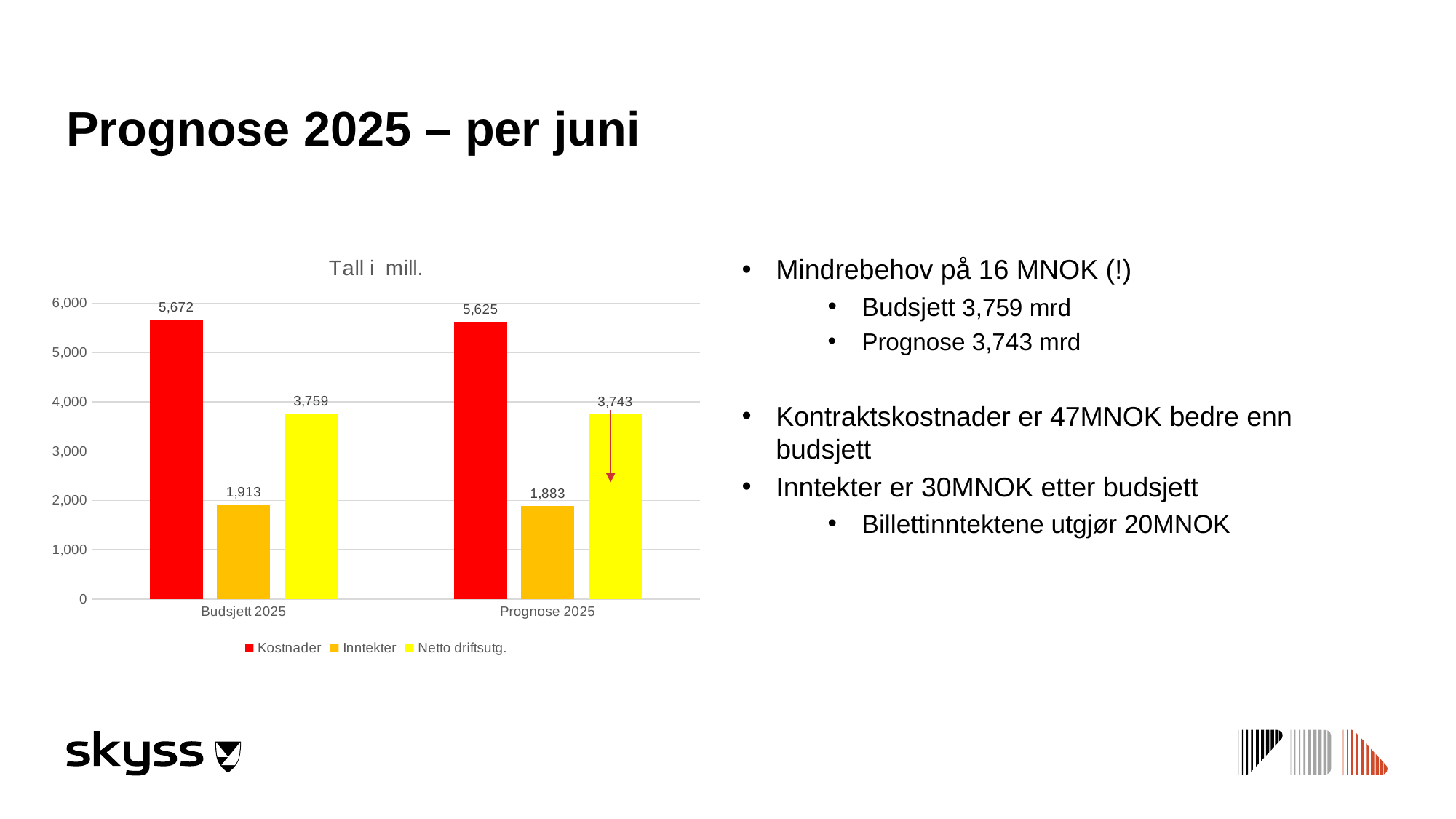
What is the value of Inntekter for Prognose 2025? 1,883 What is the difference between Kostnader for Budsjett 2025 and Kostnader for Prognose 2025? 47 What kind of chart is shown on the slide? bar chart Which series has the lowest value for Budsjett 2025? Inntekter How many series does the legend list? 3 What is the value of Netto driftsutg. for Budsjett 2025? 3,759 What is the difference between Netto driftsutg. for Budsjett 2025 and for Prognose 2025? 16 Is the value of Netto driftsutg. for Prognose 2025 greater or less than 4,000? less How many categories are shown on the x axis? 2 Which is larger: Inntekter for Budsjett 2025 or Inntekter for Prognose 2025? Budsjett 2025 What is the value of Kostnader for Budsjett 2025? 5,672 Which series has the highest value for Prognose 2025? Kostnader